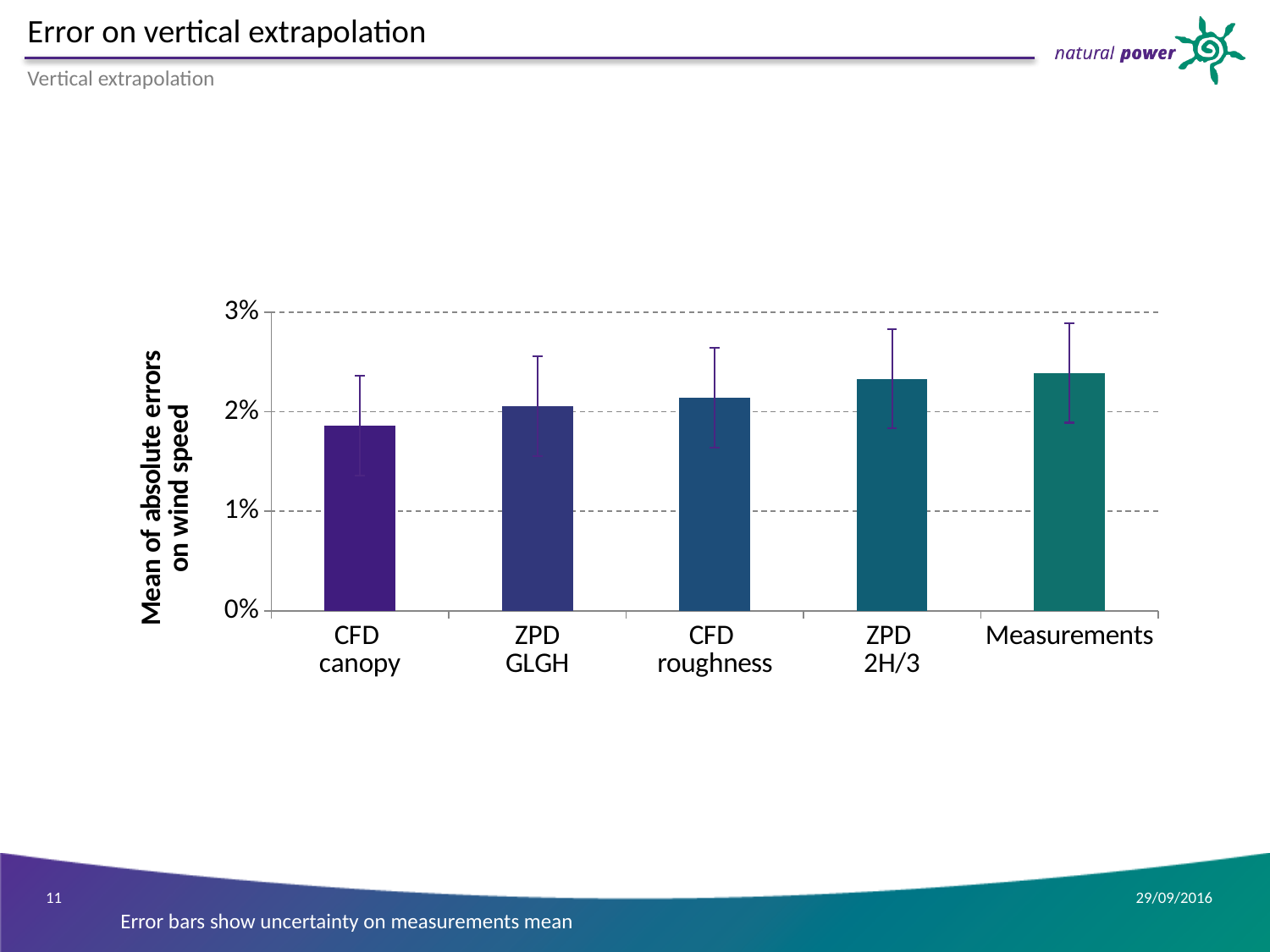
Is the value for CFD roughness greater or less than 2%? greater How many categories are plotted along the x axis? 5 Which is larger, the value for CFD canopy or the value for Measurements? Measurements What is the label of the y axis? Mean of absolute errors on wind speed Is the value for Measurements greater or less than 2%? greater Which category has the lowest mean of absolute errors on wind speed? CFD canopy Is the value for ZPD 2H/3 greater or less than 3%? less Which category has the highest mean of absolute errors on wind speed? Measurements According to the note at the bottom of the slide, what do the error bars show? Uncertainty on measurements mean Do the bar values rise or fall from left to right along the x axis? rise What kind of chart is shown on the slide? bar chart